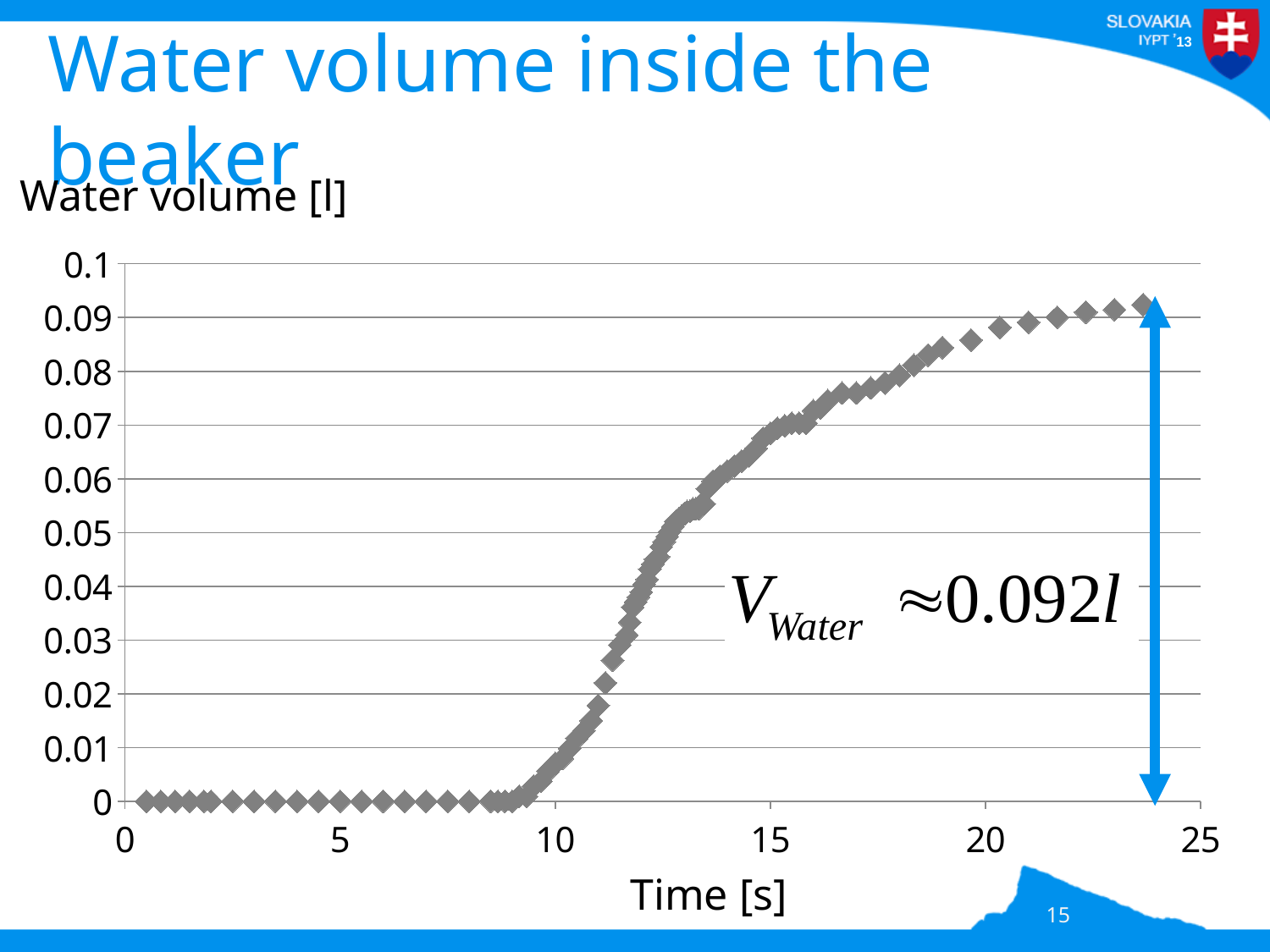
Is the water volume at time 20 s greater or less than 0.08? greater Is the water volume at time 12 s greater or less than 0.05? less Is the water volume at time 10 s greater or less than 0.02? less What is the label of the x axis? Time [s] What is the water volume at time 5 s? 0 Is the water volume larger at time 15 s or at time 10 s? 15 s Do the water volume values rise or fall as time increases along the x axis? rise What is the title of the slide's chart? Water volume inside the beaker What kind of chart is shown on the slide? scatter chart According to the annotation on the chart, what is the approximate final water volume V_Water? 0.092 l What is the highest value shown on the y axis? 0.1